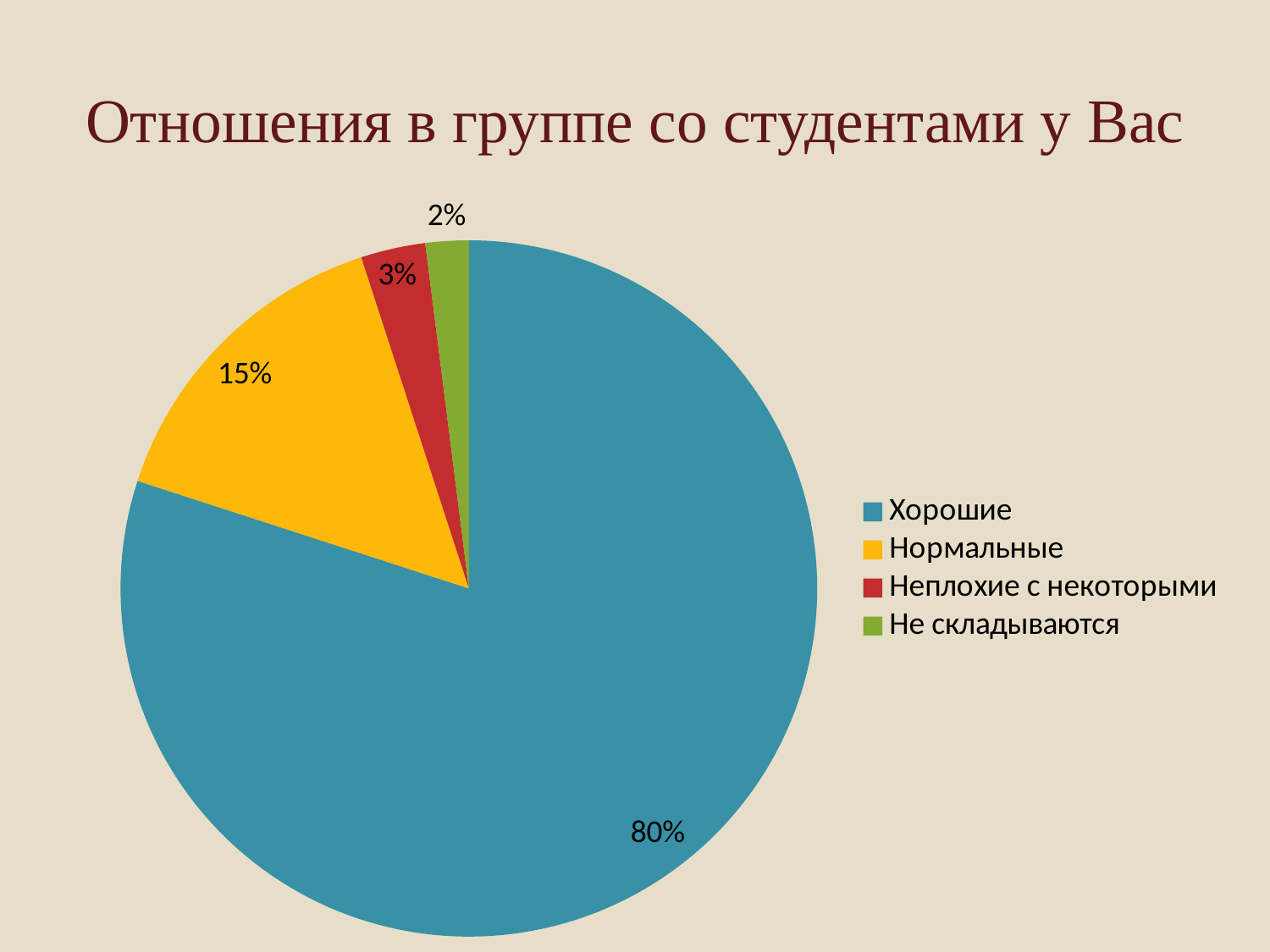
How many categories does the pie chart show? 4 What colour is the slice for "Нормальные"? Yellow Which category has the smallest slice of the pie? Не складываются Which category has the largest slice of the pie? Хорошие What is the title of the chart on the slide? Отношения в группе со студентами у Вас What is the value shown for "Не складываются"? 2% What is the difference between the shares for "Хорошие" and "Нормальные"? 65% What is the value shown for "Нормальные"? 15% What share of the pie does the "Хорошие" slice represent? 80% What kind of chart is shown on the slide? Pie chart What is the value shown for "Неплохие с некоторыми"? 3% Which is larger, the share for "Нормальные" or the share for "Неплохие с некоторыми"? Нормальные